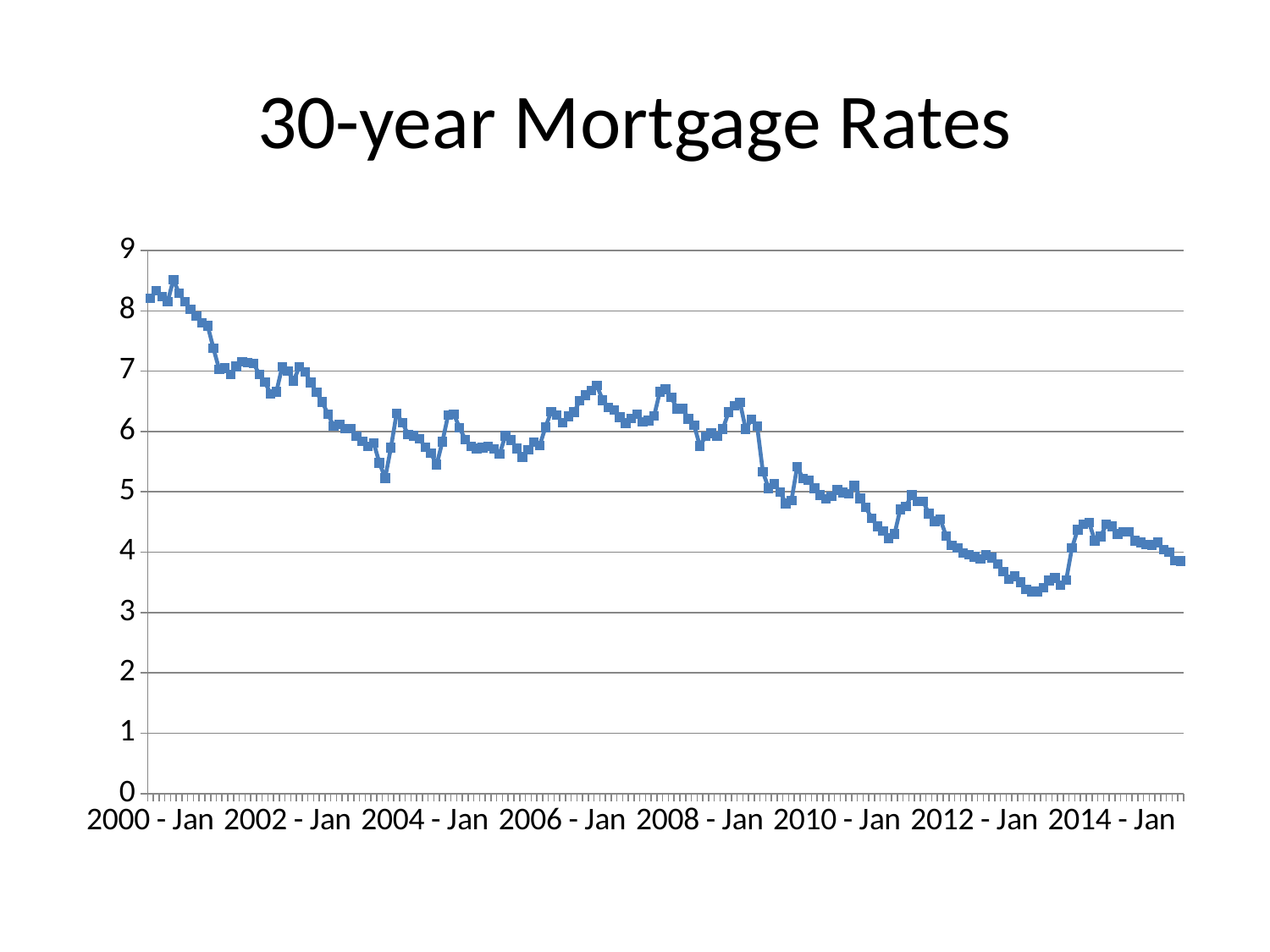
Is the value at 2012 - Jan greater or less than 5? less Is the highest point on the line greater or less than 8? greater How many date labels are shown on the x axis? 8 Is the value at 2010 - Jan greater or less than 4? greater Overall, do the mortgage rates rise or fall from 2000 - Jan to the end of the series? fall What is the title of the chart? 30-year Mortgage Rates Which is larger, the value at 2000 - Jan or the value at 2014 - Jan? 2000 - Jan Which of the labelled dates on the x axis has the highest mortgage rate? 2000 - Jan What kind of chart is shown on the slide? line chart